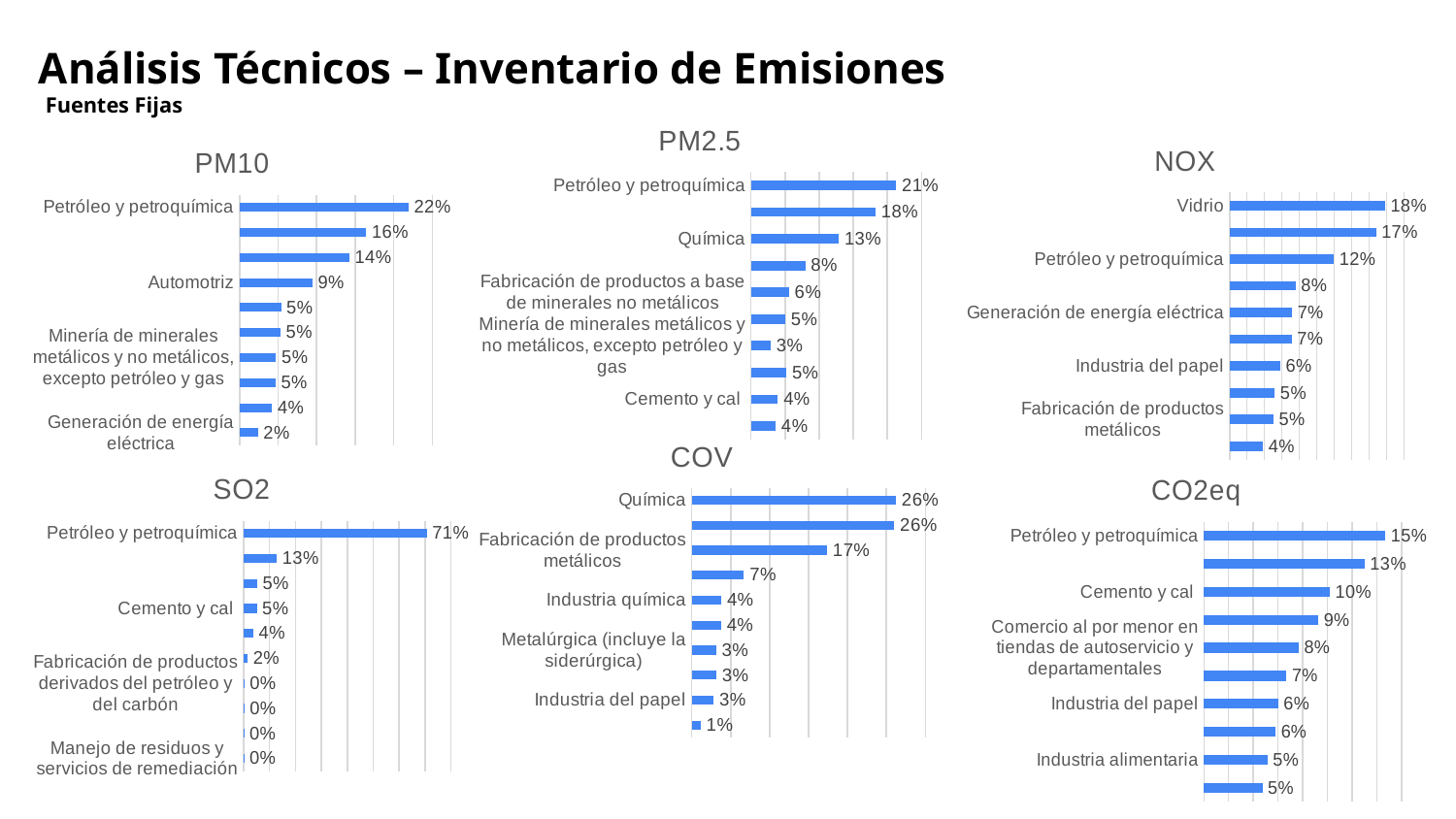
How many bars are plotted in the SO2 chart? 10 In the PM10 chart, what is the value for Automotriz? 9% What type of chart is the COV chart? Bar chart In the NOX chart, which is larger: Vidrio or Petróleo y petroquímica? Vidrio In the NOX chart, what is the value for Industria del papel? 6% In the NOX chart, which category has the highest value? Vidrio In the COV chart, what is the value for Fabricación de productos metálicos? 17% How many charts are shown on the slide? 6 In the CO2eq chart, what is the value for Cemento y cal? 10% In the PM10 chart, what is the difference between Petróleo y petroquímica and Automotriz? 13 percentage points In the SO2 chart, what is the value for Petróleo y petroquímica? 71% In the PM2.5 chart, what is the value for Química? 13%